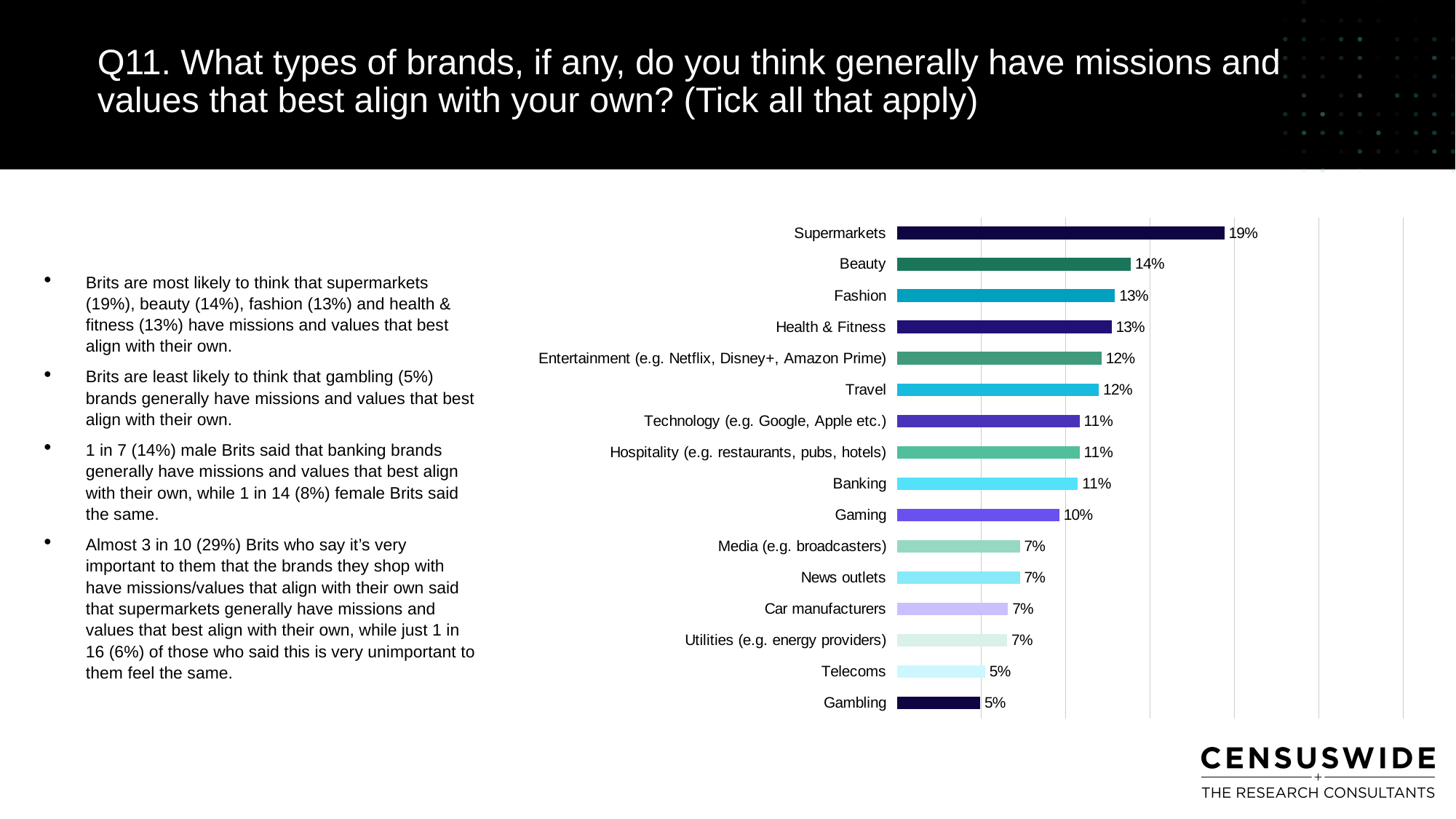
Which category has the highest value in the chart? Supermarkets What is the value shown for Beauty? 14% What is the value for Telecoms? 5% Which category is listed at the bottom of the chart? Gambling What percentage is shown for Gaming? 10% What is the difference between the values for Gaming and Gambling? 5% What is the difference between the values for Supermarkets and Beauty? 5% Which has a larger value, Fashion or Banking? Fashion What type of chart is shown on the slide? Bar chart Which has a larger value, Travel or Media (e.g. broadcasters)? Travel What percentage of respondents selected Supermarkets? 19% How many categories are shown in the chart? 16